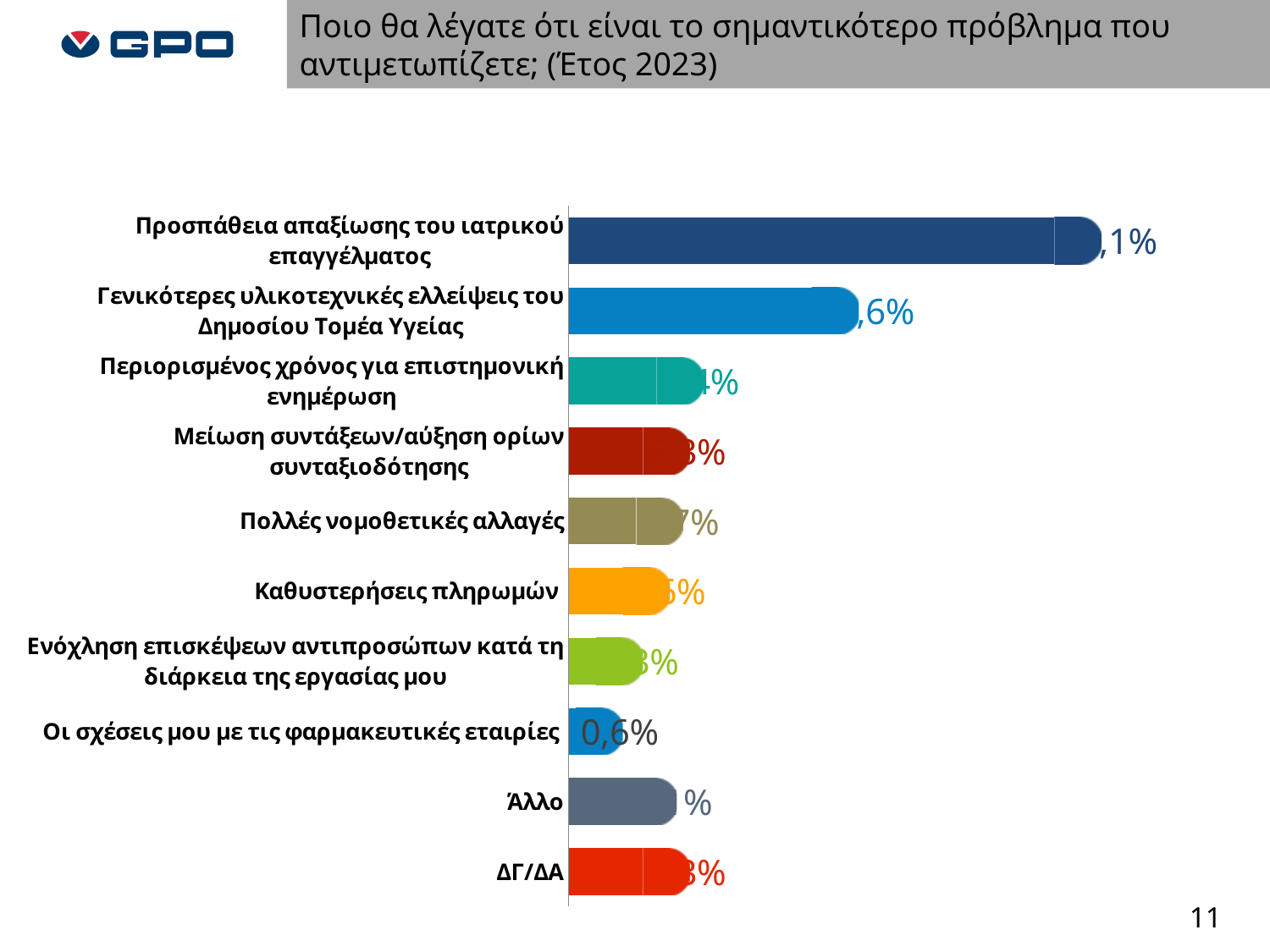
What kind of chart is shown on the slide? Bar chart Which is larger: 'Περιορισμένος χρόνος για επιστημονική ενημέρωση' or 'Καθυστερήσεις πληρωμών'? Περιορισμένος χρόνος για επιστημονική ενημέρωση Which year does the chart title say the data refers to? 2023 Which is larger: 'Γενικότερες υλικοτεχνικές ελλείψεις του Δημοσίου Τομέα Υγείας' or 'Πολλές νομοθετικές αλλαγές'? Γενικότερες υλικοτεχνικές ελλείψεις του Δημοσίου Τομέα Υγείας What is the value for 'Οι σχέσεις μου με τις φαρμακευτικές εταιρίες'? 0,6% Which is larger: 'Άλλο' or 'Οι σχέσεις μου με τις φαρμακευτικές εταιρίες'? Άλλο Which category has the highest value in the chart? Προσπάθεια απαξίωσης του ιατρικού επαγγέλματος How many categories (problems) are plotted in the chart? 10 Which category has the lowest value in the chart? Οι σχέσεις μου με τις φαρμακευτικές εταιρίες Which category is listed at the bottom of the chart? ΔΓ/ΔΑ